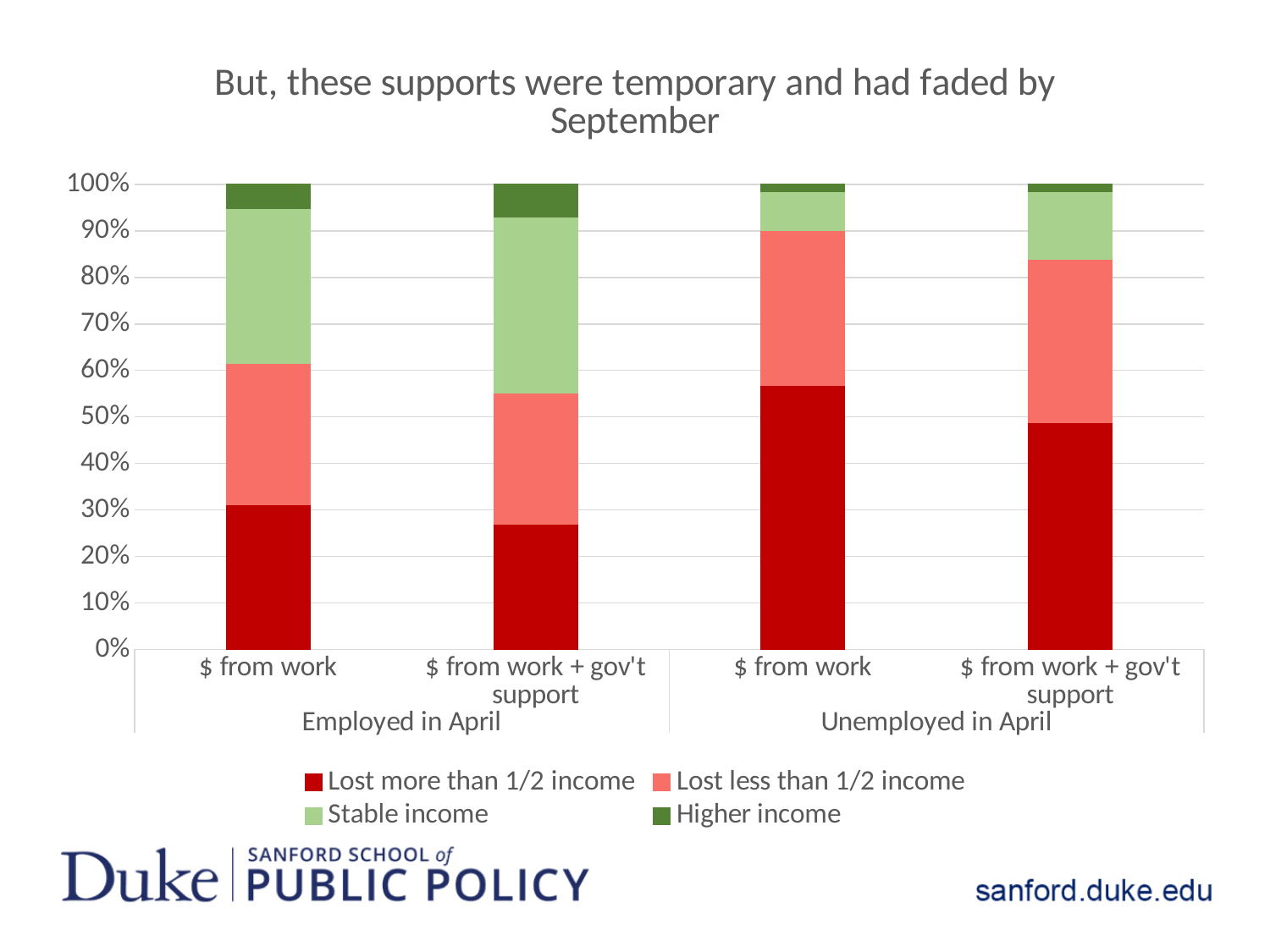
How many series does the legend list? 4 Which bar has the largest 'Lost more than 1/2 income' segment? $ from work, Unemployed in April Is the 'Lost more than 1/2 income' share for '$ from work' under 'Employed in April' greater or less than 40%? less What colour represents 'Stable income' in the legend? Light green Which bar has the largest 'Stable income' segment? $ from work + gov't support, Employed in April What does each stacked bar total? 100% Is the 'Lost more than 1/2 income' share for '$ from work + gov't support' under 'Unemployed in April' greater or less than 40%? greater Which bar has the smallest 'Lost more than 1/2 income' segment? $ from work + gov't support, Employed in April How many bars are plotted in the chart? 4 What kind of chart is shown on the slide? Stacked bar chart Is the 'Lost more than 1/2 income' segment larger for '$ from work' under 'Employed in April' or for '$ from work' under 'Unemployed in April'? $ from work, Unemployed in April Is the 'Lost more than 1/2 income' share for '$ from work' under 'Unemployed in April' greater or less than 50%? greater